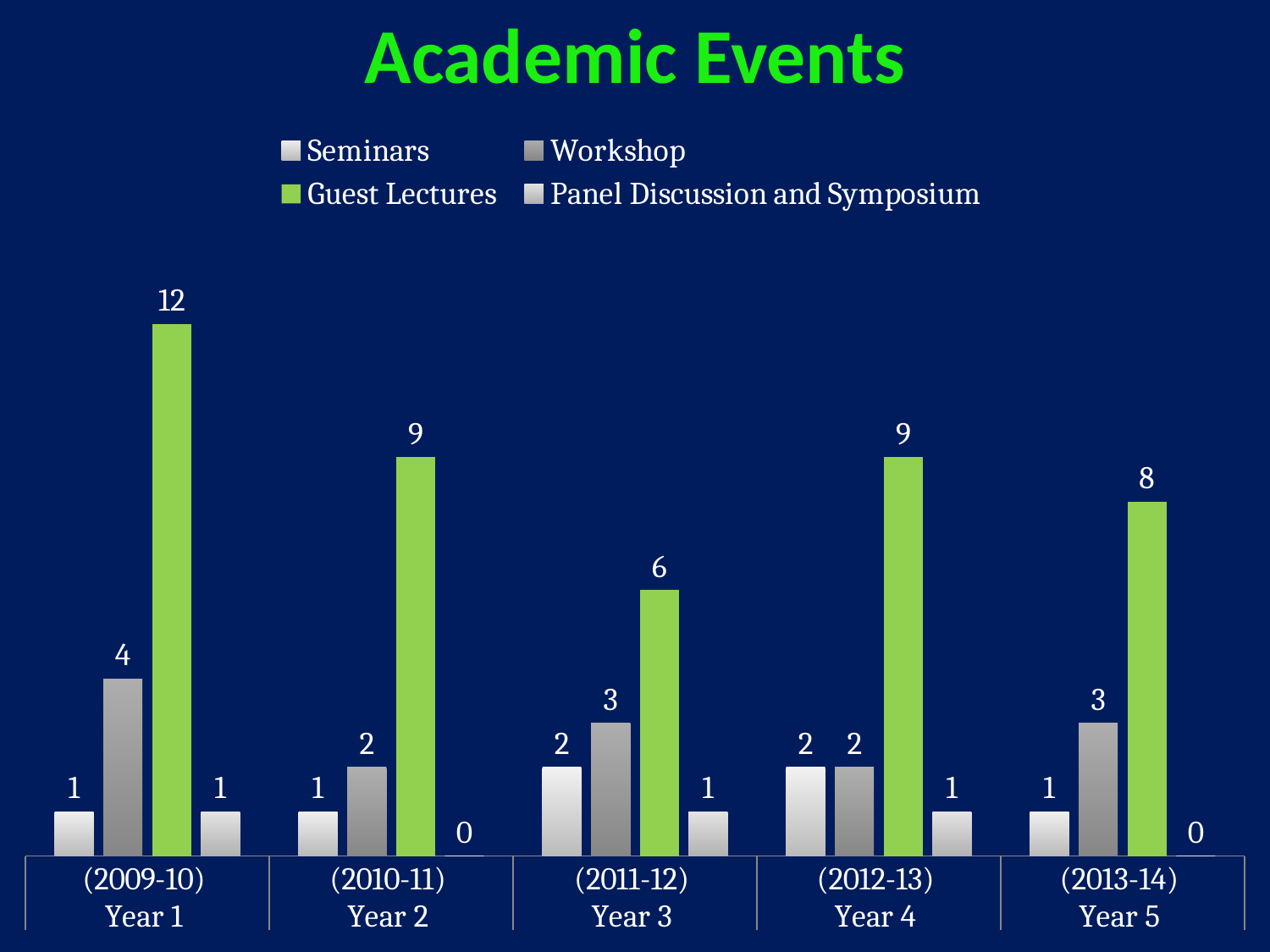
How many years (categories) are shown on the x axis? 5 Which is larger, the Workshop value in Year 1 or the Workshop value in Year 5? Year 1 How many series does the legend list? 4 What is the difference between the Guest Lectures values in Year 1 and Year 2? 3 In which year is the Guest Lectures value lowest? Year 3 (2011-12) In which year is the Guest Lectures value highest? Year 1 (2009-10) What is the value for Workshop in Year 3 (2011-12)? 3 What is the total of all four series in Year 3 (2011-12)? 12 What is the value for Guest Lectures in Year 1 (2009-10)? 12 What is the value for Panel Discussion and Symposium in Year 5 (2013-14)? 0 What is the title of the chart? Academic Events What kind of chart is shown on the slide? Bar chart